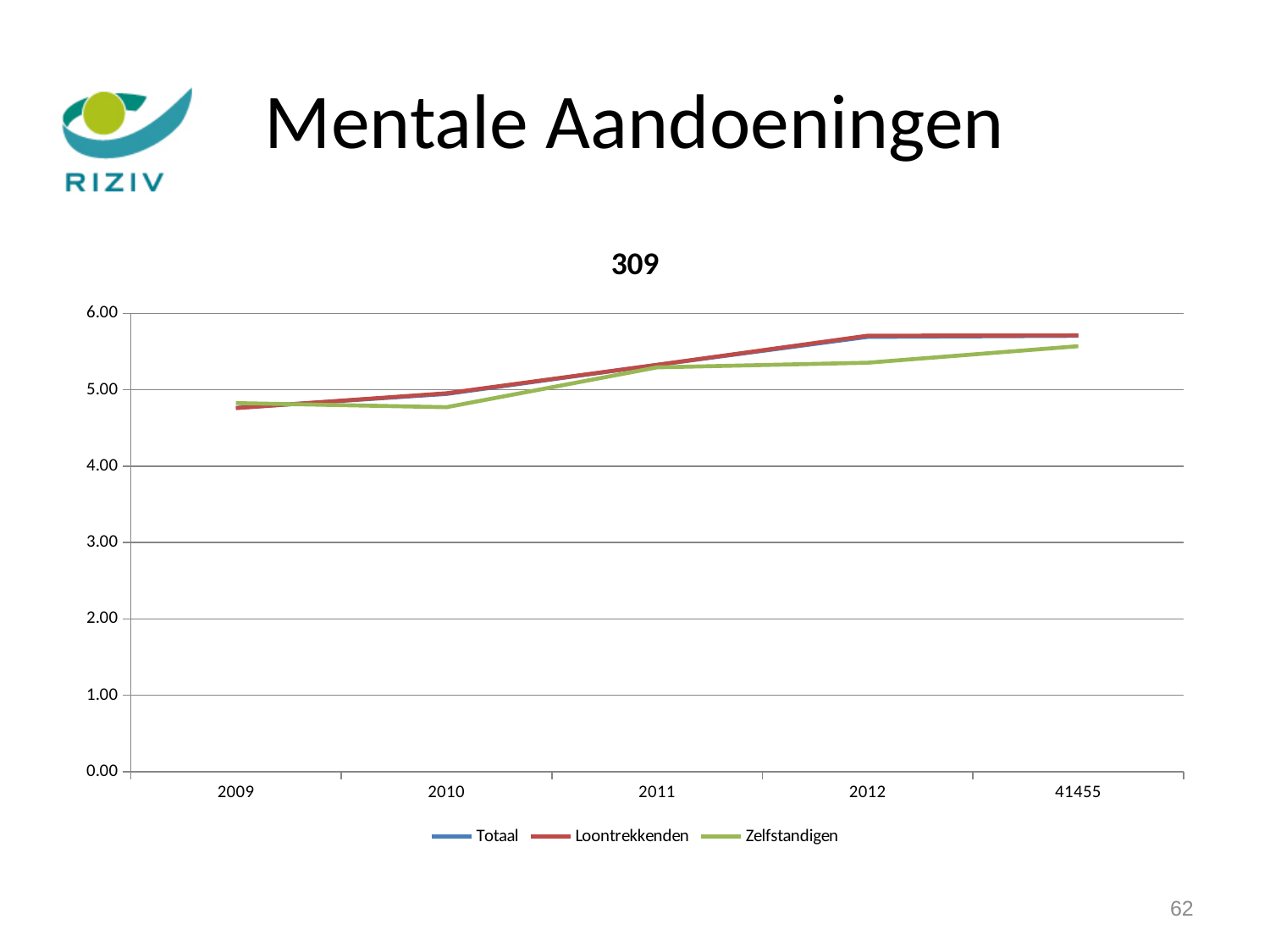
Is the value for Zelfstandigen in 2010 greater or less than 5.00? less How many points are plotted along the x axis for each series? 5 For the Loontrekkenden series, which x-axis category has the lowest value? 2009 Is the value for Loontrekkenden in 2012 greater or less than 5.00? greater Is the value for Loontrekkenden in 2009 greater or less than 5.00? less What is the title of the chart? 309 What kind of chart is shown on the slide? line chart In 2012, which is larger: Loontrekkenden or Zelfstandigen? Loontrekkenden Do the values for Loontrekkenden rise or fall from 2009 to 2012? rise Which series is drawn in green in the legend? Zelfstandigen How many series does the legend list? 3